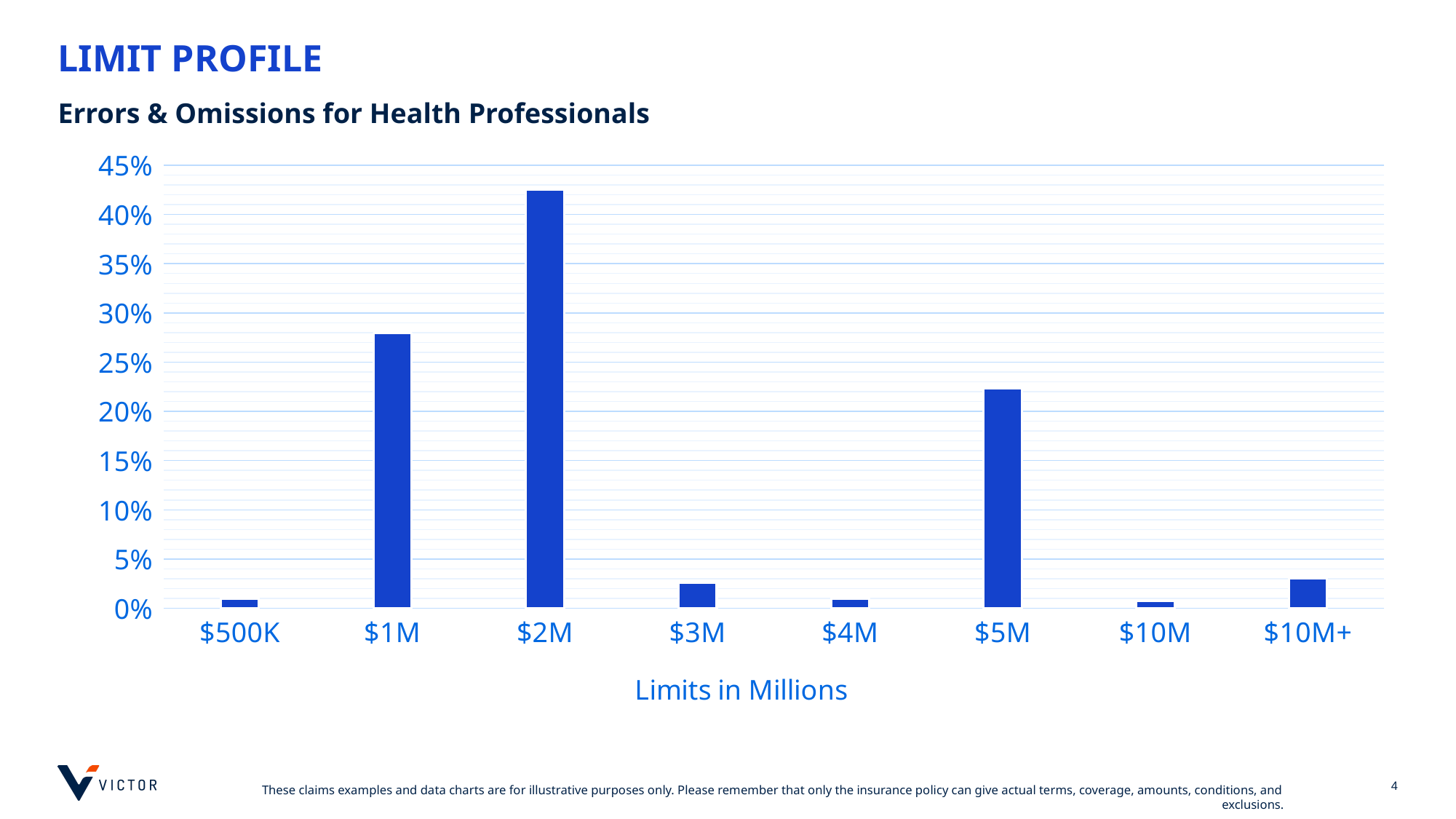
Is the value for $3M greater or less than 5%? less Which limit category has the highest percentage? $2M Which has a larger value, $1M or $5M? $1M Is the value for $2M greater or less than 40%? greater What is the subtitle of the chart below 'LIMIT PROFILE'? Errors & Omissions for Health Professionals Is the value for $5M greater or less than 20%? greater Which has a larger value, $3M or $2M? $2M What kind of chart is shown on the slide? Bar chart What is the title of the x axis? Limits in Millions How many limit categories are shown on the x axis? 8